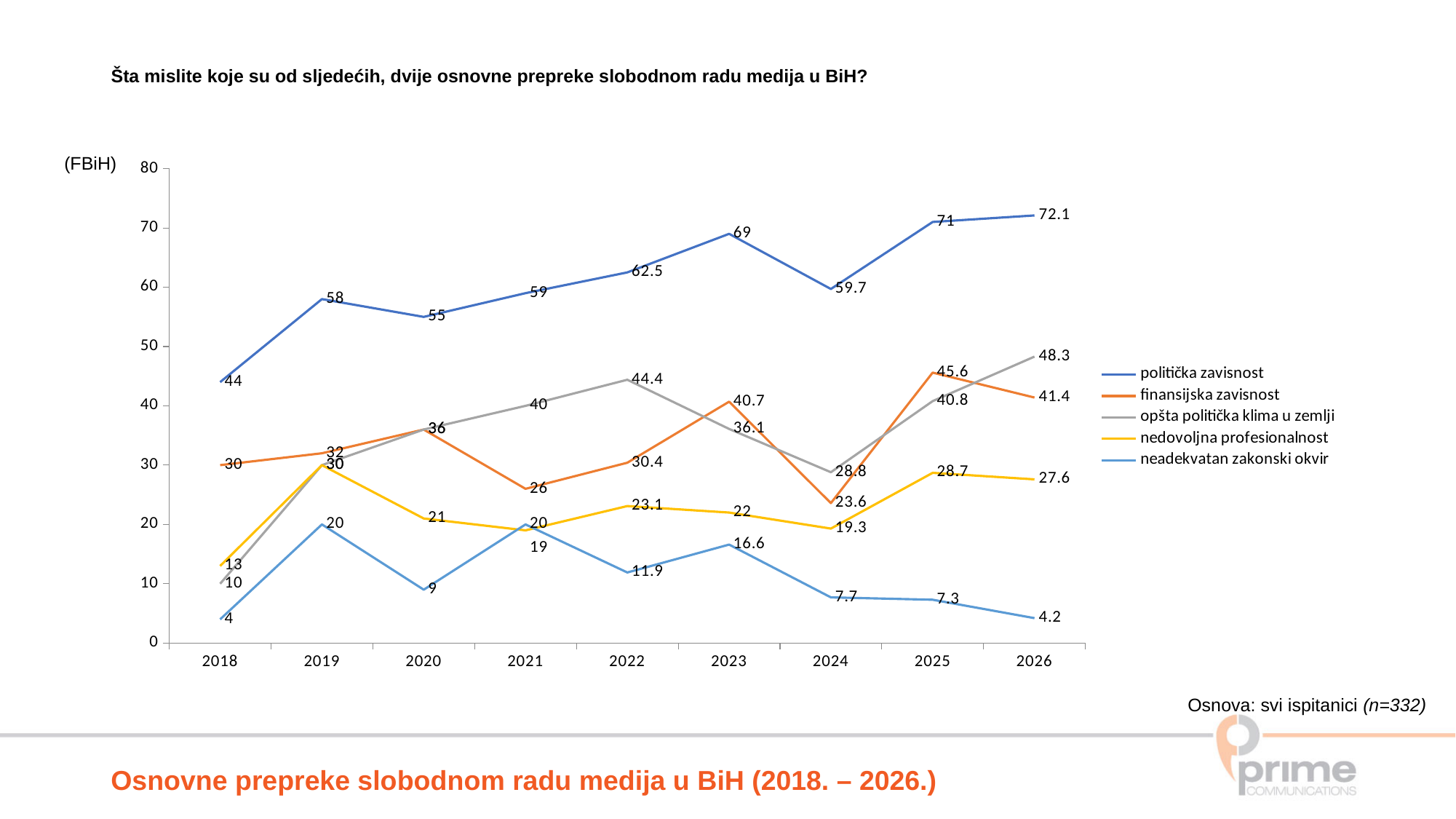
In which year does politička zavisnost reach its highest value? 2026 What kind of chart is shown on the slide? line chart What is the value for politička zavisnost in 2026? 72.1 In which year is opšta politička klima u zemlji at its lowest value? 2018 What is the value for opšta politička klima u zemlji in 2022? 44.4 What is the value for neadekvatan zakonski okvir in 2018? 4 How many years are shown on the x axis? 9 What is the value for finansijska zavisnost in 2025? 45.6 How many series does the legend list? 5 Is the value for politička zavisnost in 2023 greater or less than 60? greater By how much did politička zavisnost increase from 2018 to 2026? 28.1 In 2023, which is larger: finansijska zavisnost or opšta politička klima u zemlji? finansijska zavisnost